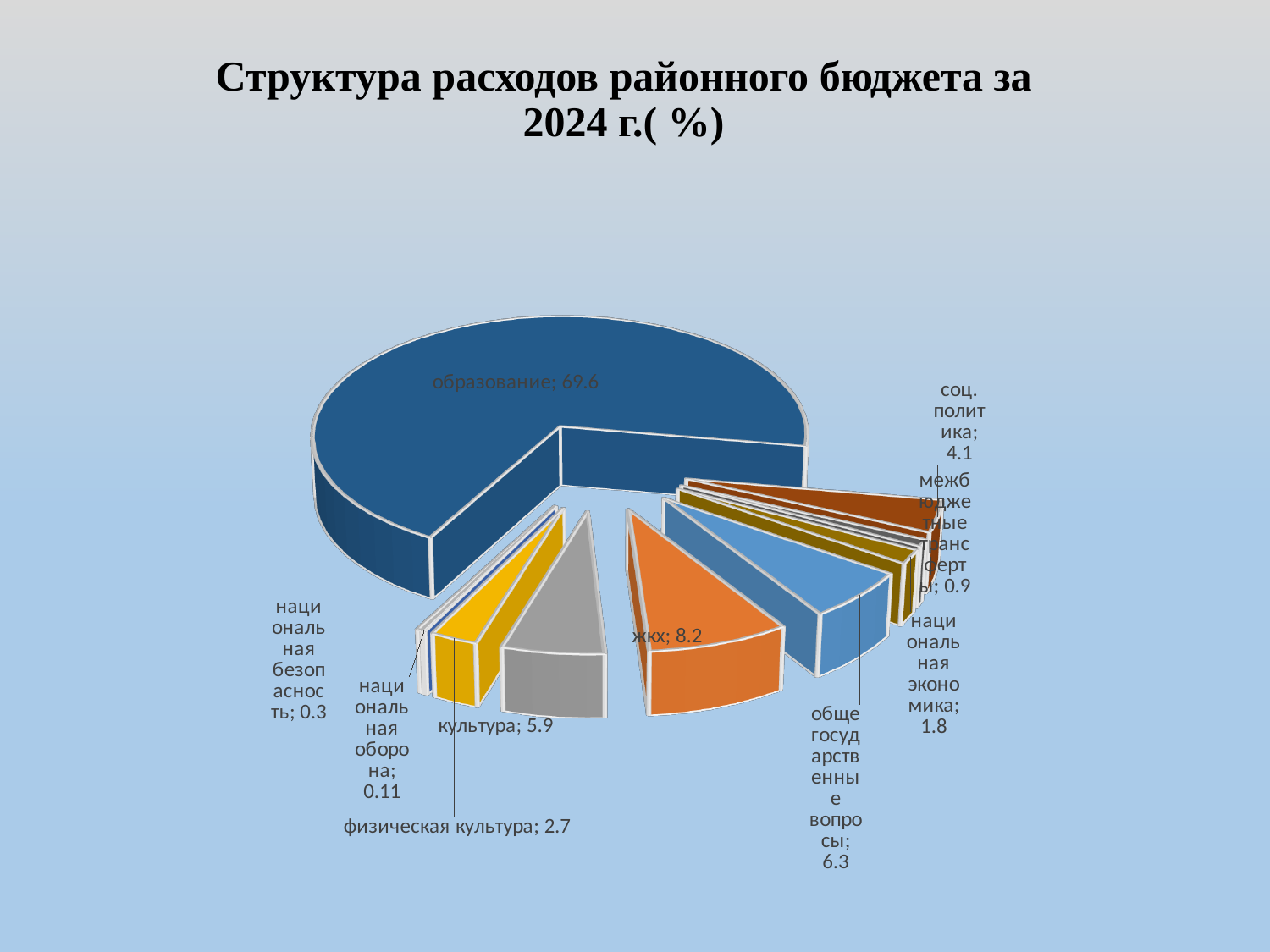
What is the value for общегосударственные вопросы? 6.3 What is the value for соц. политика? 4.1 Which category has the largest share of the pie? образование Which is larger, физическая культура or национальная экономика? физическая культура What is the title of the chart? Структура расходов районного бюджета за 2024 г.( %) What kind of chart is shown on the slide? pie chart Which category has the smallest share of the pie? национальная оборона What is the difference between the values for жкх and культура? 2.3 How many categories are shown in the pie chart? 10 What is the value for образование? 69.6 What is the value for жкх? 8.2 What is the value for национальная оборона? 0.11